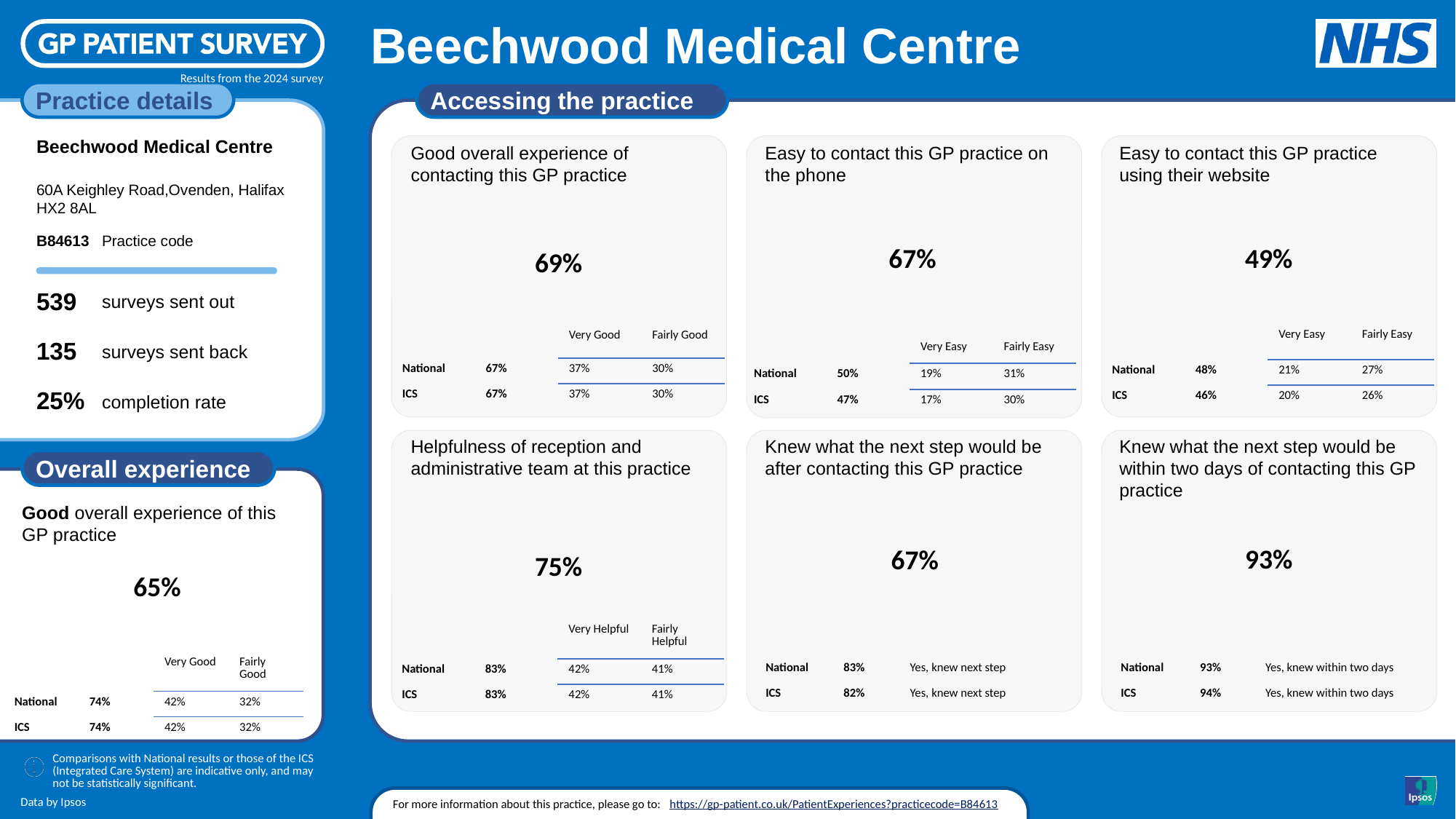
In the 'Easy to contact this GP practice on the phone' panel, what is the difference between the National value and the ICS value? 3% Among the six 'Accessing the practice' panels, which has the highest practice headline percentage? Knew what the next step would be within two days of contacting this GP practice In the 'Good overall experience of this GP practice' panel under Overall experience, what is the practice's headline percentage? 65% In the 'Knew what the next step would be within two days of contacting this GP practice' panel, what is the practice's headline percentage? 93% Which is larger in the 'Easy to contact this GP practice using their website' panel: the practice's headline value or the ICS value? the practice's headline value Which is larger in the 'Knew what the next step would be after contacting this GP practice' panel: the practice's headline value or the National value? the National value In the 'Good overall experience of contacting this GP practice' panel, what is the practice's headline percentage? 69% In the 'Helpfulness of reception and administrative team at this practice' panel, what is the ICS 'Very Helpful' value? 42% In the 'Good overall experience of this GP practice' panel, what is the difference between the National value (74%) and the practice's headline value (65%)? 9% Among the six 'Accessing the practice' panels, which has the lowest practice headline percentage? Easy to contact this GP practice using their website In the 'Easy to contact this GP practice on the phone' panel, what is the practice's headline percentage? 67% In the 'Easy to contact this GP practice using their website' panel, what is the National value? 48%